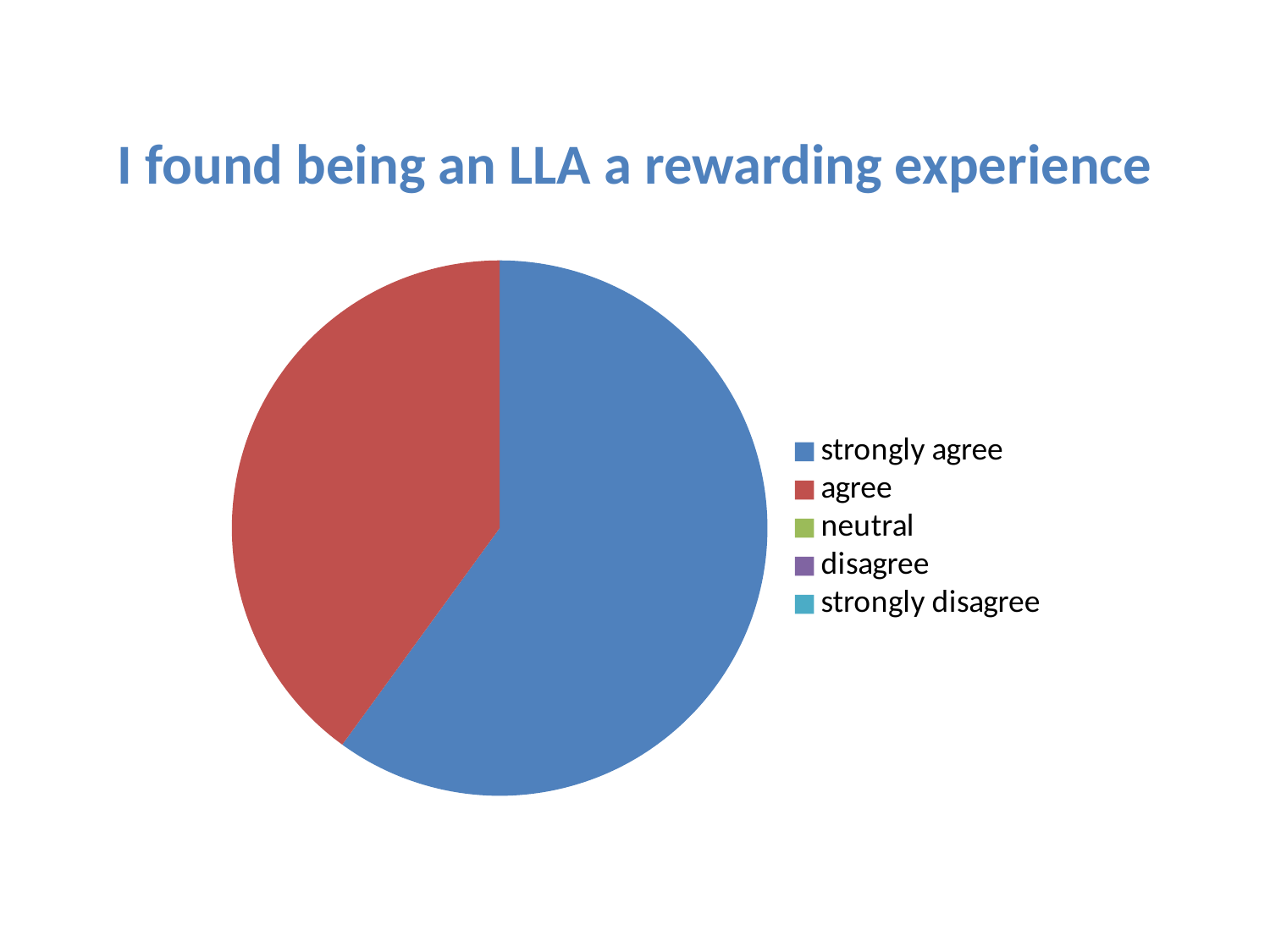
What is the title of the chart? I found being an LLA a rewarding experience Which two categories have visible slices in the pie? strongly agree and agree How many slices are visible in the pie? 2 Which is larger, the slice for strongly agree or the slice for agree? strongly agree Does the strongly agree slice take up more or less than half of the pie? more Which category has the largest slice of the pie? strongly agree What kind of chart is shown on the slide? pie chart Which colour represents the agree category in the legend? red How many categories does the legend list? 5